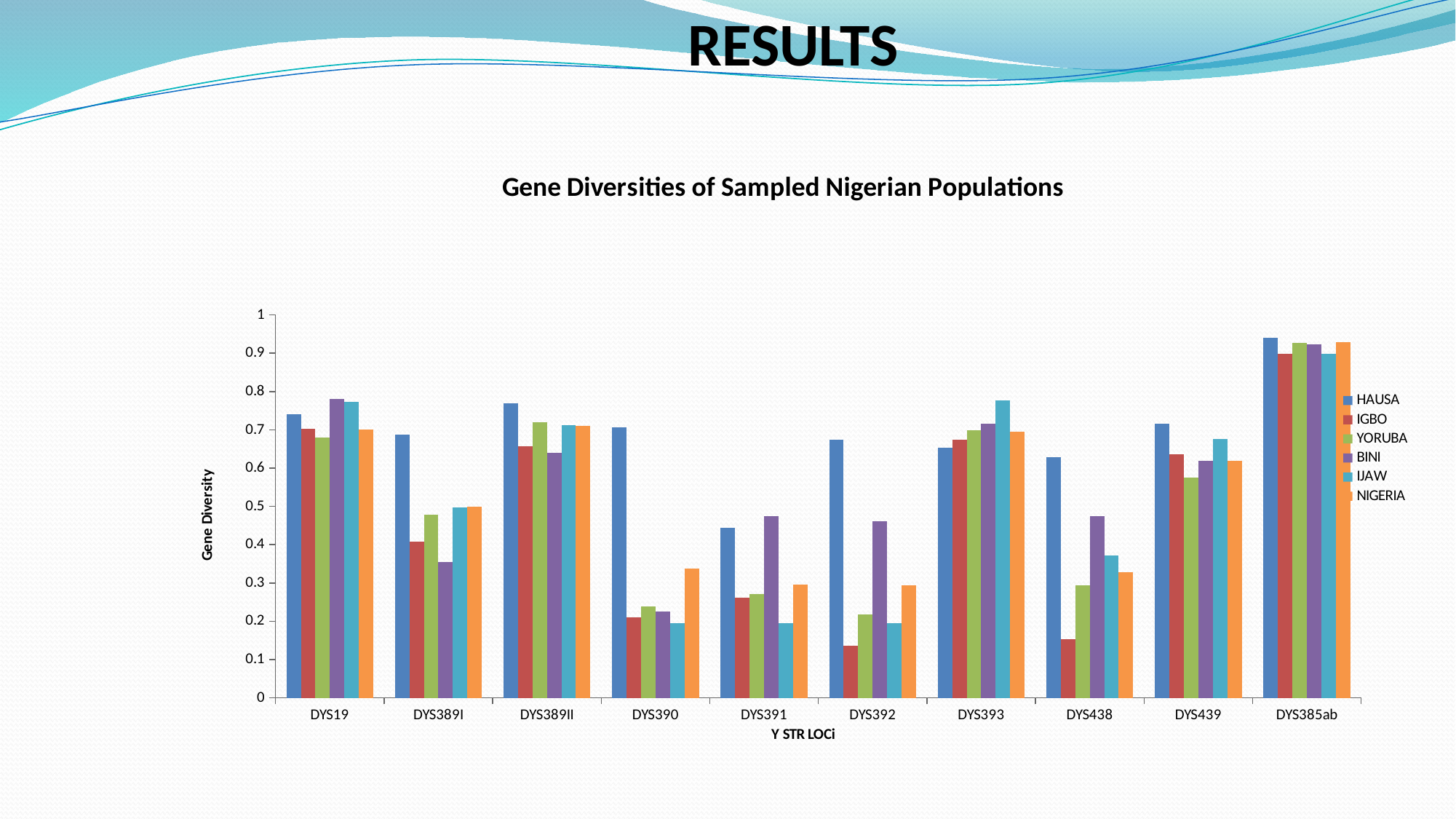
What is the title of the chart? Gene Diversities of Sampled Nigerian Populations Which population has the lowest gene diversity at DYS438? IGBO Which population has the highest gene diversity at DYS392? HAUSA What kind of chart is shown on the slide? bar chart Which population has the highest gene diversity at DYS393? IJAW What is the title of the y axis? Gene Diversity Is the gene diversity for HAUSA at DYS390 greater or less than 0.5? greater Is the gene diversity for BINI at DYS389I greater or less than 0.4? less How many series does the legend list? 6 Is the gene diversity for IGBO at DYS392 greater or less than 0.2? less At DYS391, which has the larger gene diversity, HAUSA or IGBO? HAUSA How many Y STR loci are shown along the x axis? 10